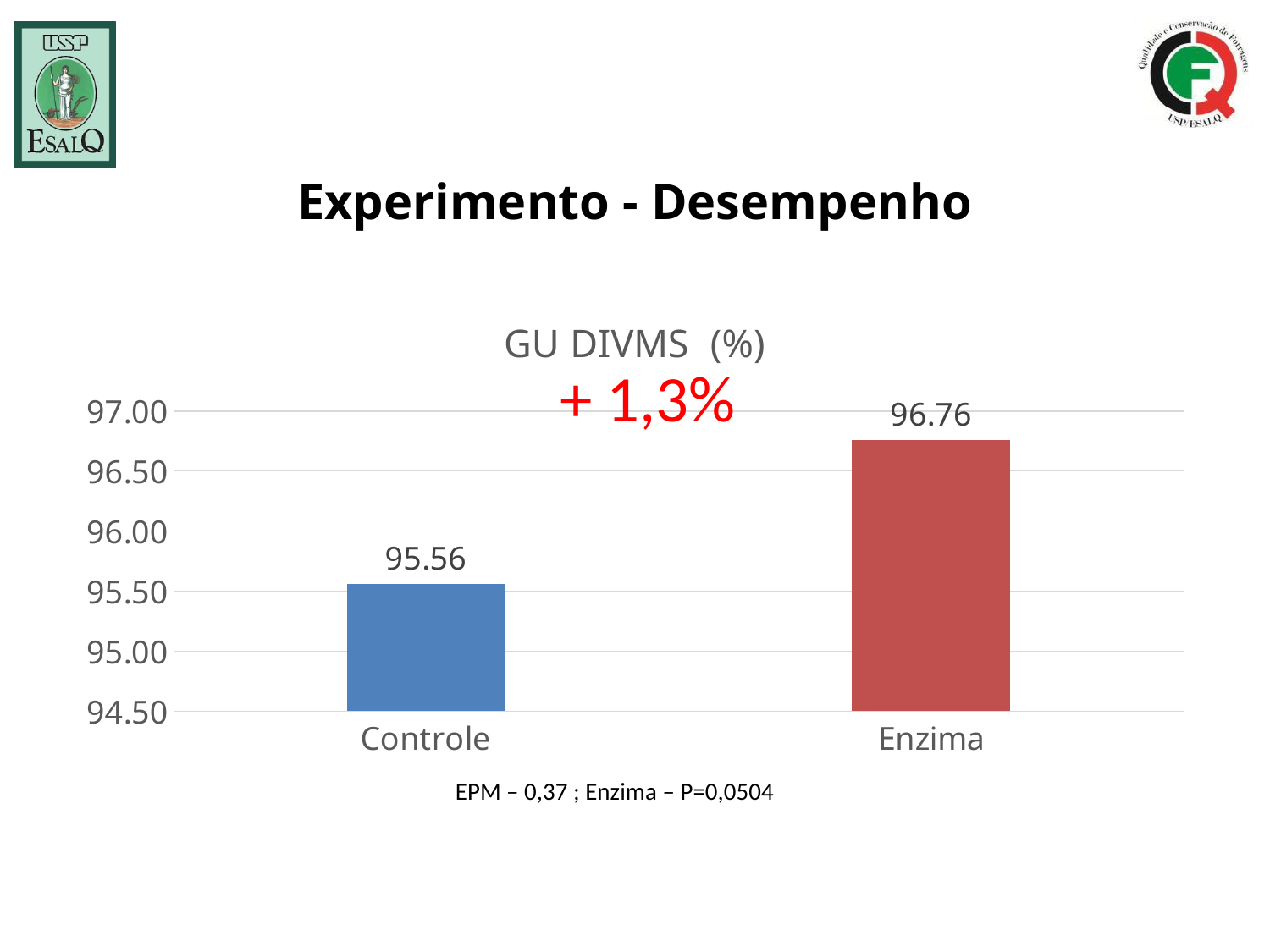
What kind of chart is shown on the slide? bar chart What is the value for Enzima? 96.76 What is the value for Controle? 95.56 What is the title of the chart? GU DIVMS (%) Which category has the highest value? Enzima What colour is the bar for Enzima? red Which category has the lowest value? Controle Is the value for Controle greater or less than 96.00? less Is the value for Enzima greater or less than 96.50? greater Which is larger, the value for Controle or the value for Enzima? Enzima How many categories are shown on the chart? 2 What is the difference between the Enzima and Controle values? 1.20